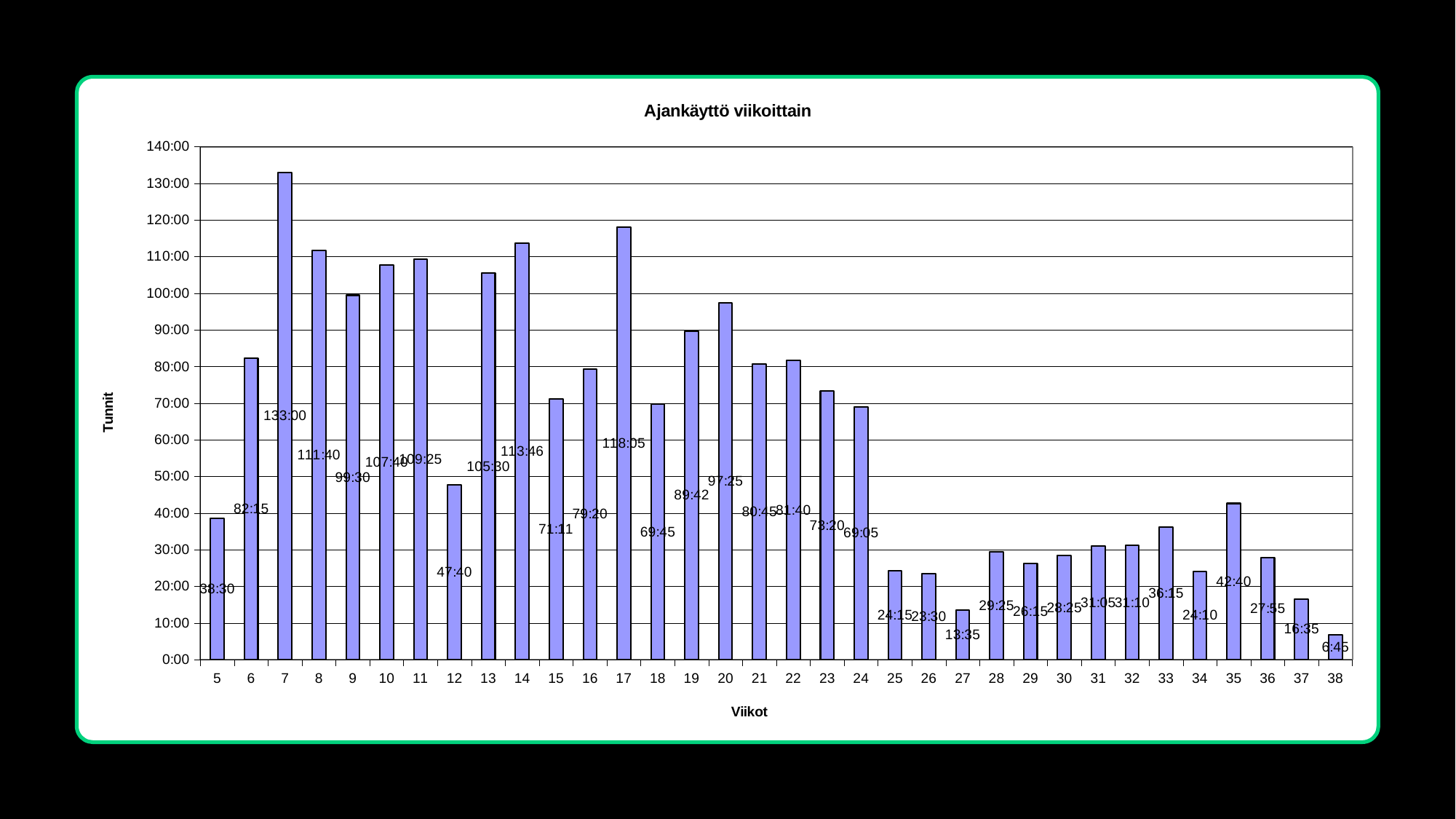
Which week has the lowest value? 38 Do the values rise or fall from week 5 to week 7? rise Which week has the highest value? 7 Is the value for week 25 greater or less than 30:00? less Which is larger, the value for week 17 or the value for week 14? week 17 What is the value for week 27? 13:35 What kind of chart is this? bar chart What is the value for week 35? 42:40 What is the title of the chart? Ajankäyttö viikoittain What is the value for week 7? 133:00 What is the difference between the values for week 12 and week 5? 9:10 How many weeks are shown on the x axis? 34